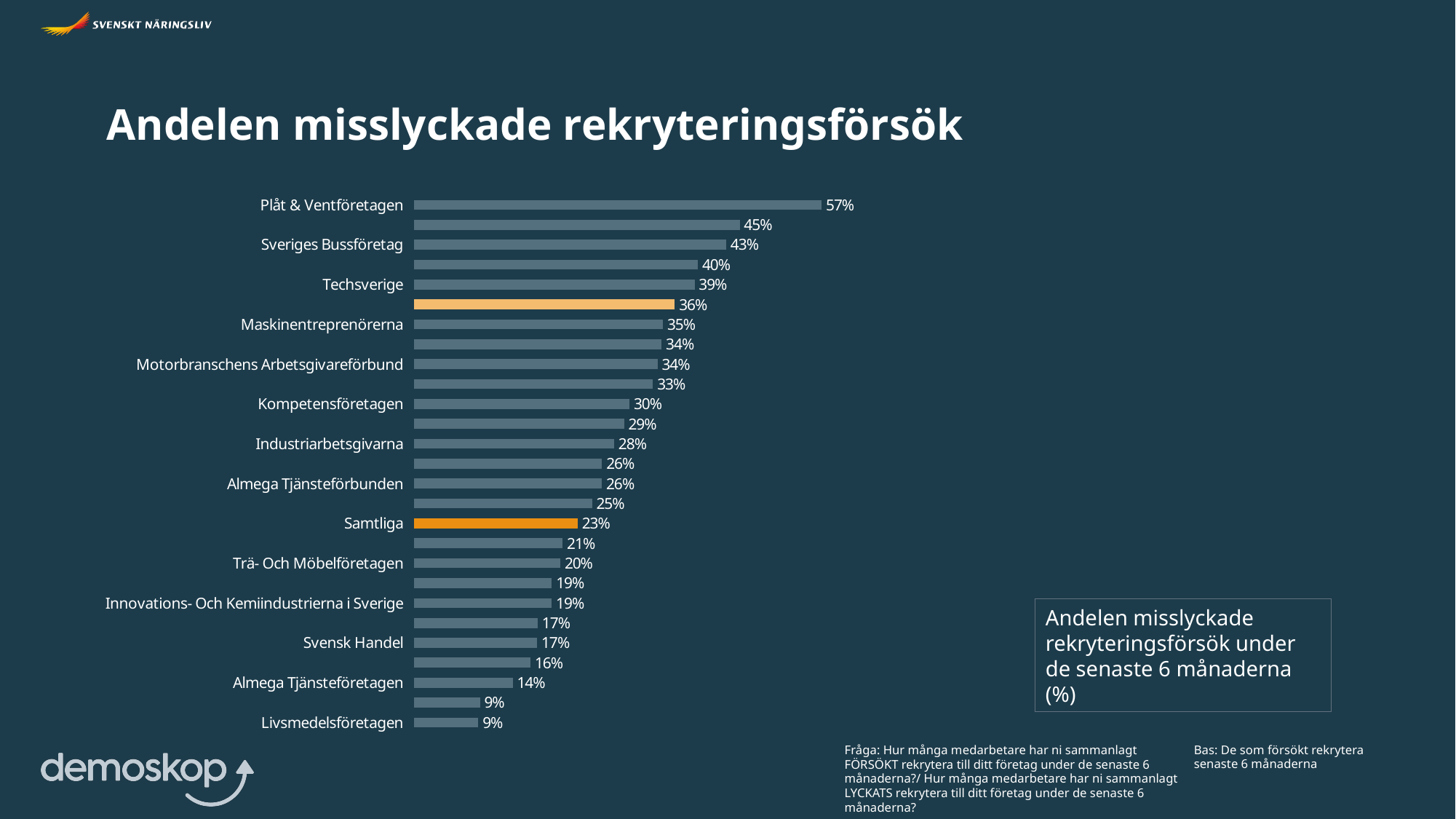
What is the value for Techsverige? 39% Which labelled category has the highest value? Plåt & Ventföretagen What is the difference in percentage points between Plåt & Ventföretagen and Samtliga? 34 What is the value for Plåt & Ventföretagen? 57% What is the title of the slide? Andelen misslyckade rekryteringsförsök What is the value for Samtliga? 23% What is the lowest value shown in the chart? 9% What is the value for Livsmedelsföretagen? 9% What type of chart is shown on the slide? Bar chart Which is larger, the value for Sveriges Bussföretag or the value for Kompetensföretagen? Sveriges Bussföretag What is the value for Almega Tjänsteföretagen? 14% How many bars are plotted in the chart? 27